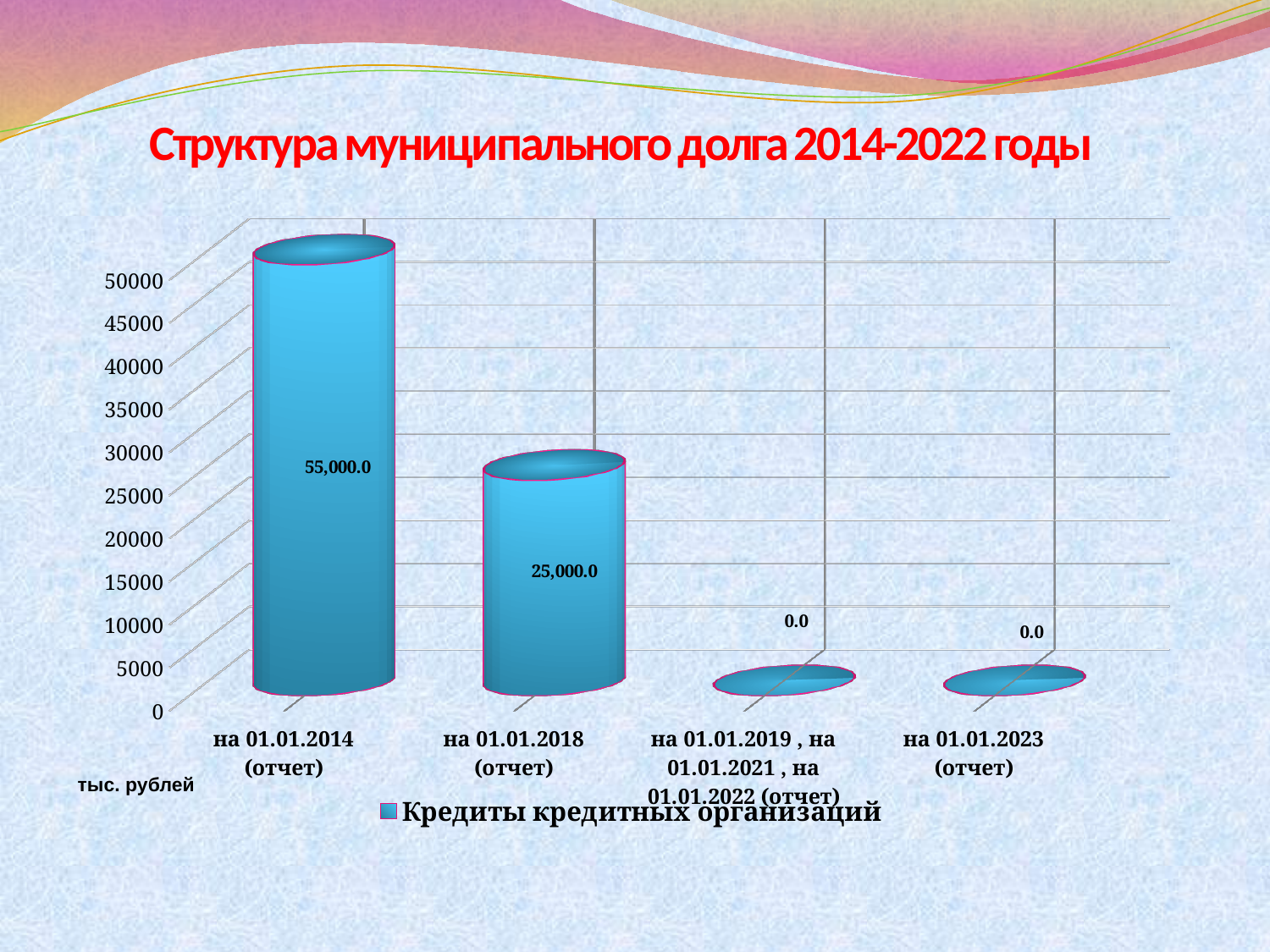
What kind of chart is shown on the slide? bar chart Is the value for "на 01.01.2018 (отчет)" greater or less than 30000? less How many series does the legend list? 1 Which is larger, the value for "на 01.01.2014 (отчет)" or "на 01.01.2018 (отчет)"? на 01.01.2014 (отчет) What is the title of the chart? Структура муниципального долга 2014-2022 годы What is the value for "на 01.01.2014 (отчет)"? 55,000.0 How many categories are shown on the x axis? 4 Which category has the highest value? на 01.01.2014 (отчет) What is the value for "на 01.01.2018 (отчет)"? 25,000.0 What is the difference between the values for "на 01.01.2014 (отчет)" and "на 01.01.2018 (отчет)"? 30,000.0 What is the value for "на 01.01.2023 (отчет)"? 0.0 Do the values rise or fall from left to right along the x axis? fall